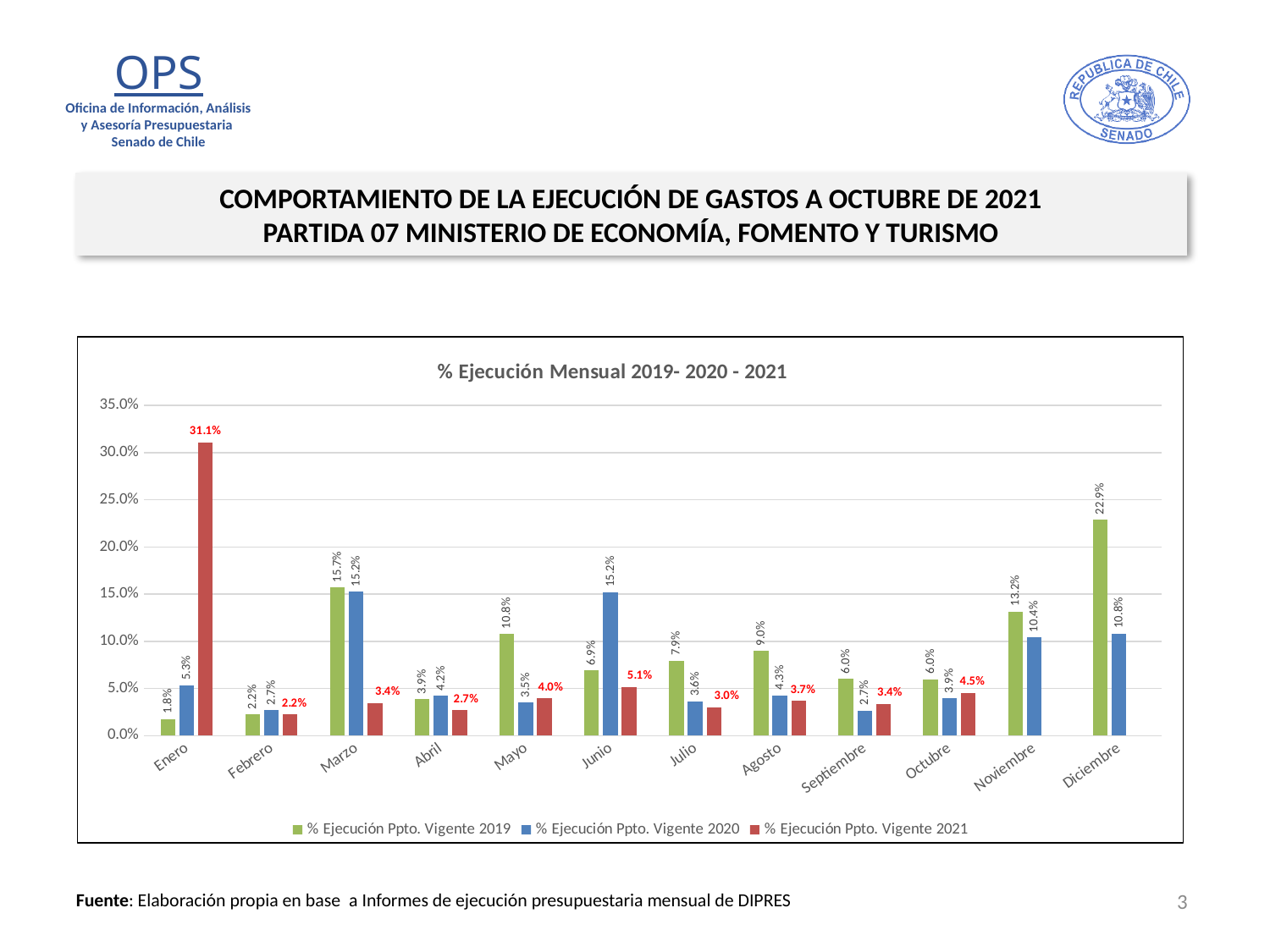
What is the value for % Ejecución Ppto. Vigente 2021 in Enero? 31.1% How many months are shown on the x axis? 12 What is the value for % Ejecución Ppto. Vigente 2020 in Junio? 15.2% What is the difference between the 2019 and 2020 values in Marzo? 0.5% How many series does the legend list? 3 Is the value for % Ejecución Ppto. Vigente 2021 in Enero greater or less than 30.0%? greater Which month has the lowest value for % Ejecución Ppto. Vigente 2019? Enero What is the value for % Ejecución Ppto. Vigente 2019 in Diciembre? 22.9% What kind of chart is shown on the slide? Bar chart What is the title of the chart? % Ejecución Mensual 2019- 2020 - 2021 Which is larger in Mayo: the 2019 value or the 2020 value? 2019 value Which month has the highest value for % Ejecución Ppto. Vigente 2021? Enero